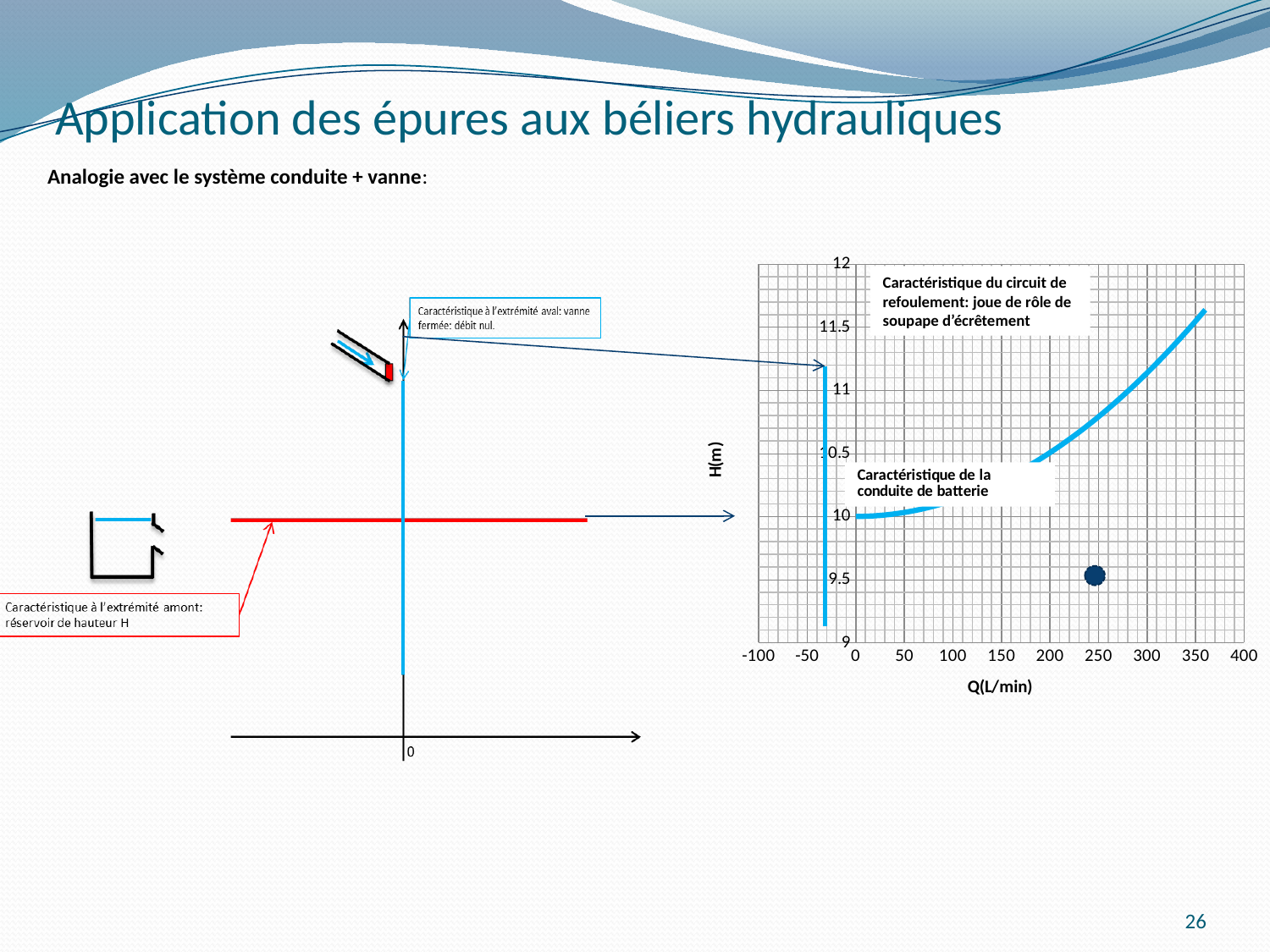
Is the value of H on the rising curve at Q = 100 L/min greater or less than 10.5? less Is the H value of the isolated dot plotted near Q = 250 L/min greater or less than 10? less What is the lowest value shown on the horizontal axis of the chart? -100 Is the value of H on the rising curve at Q = 250 L/min greater or less than 10.5? greater What is the spacing between consecutive tick labels on the horizontal axis of the chart? 50 What is the label of the vertical axis of the chart? H(m) What is the highest value shown on the horizontal axis of the chart? 400 What is the label of the horizontal axis of the chart? Q(L/min) What is the highest value shown on the vertical axis of the chart? 12 What kind of chart is shown on the right of the slide? line chart